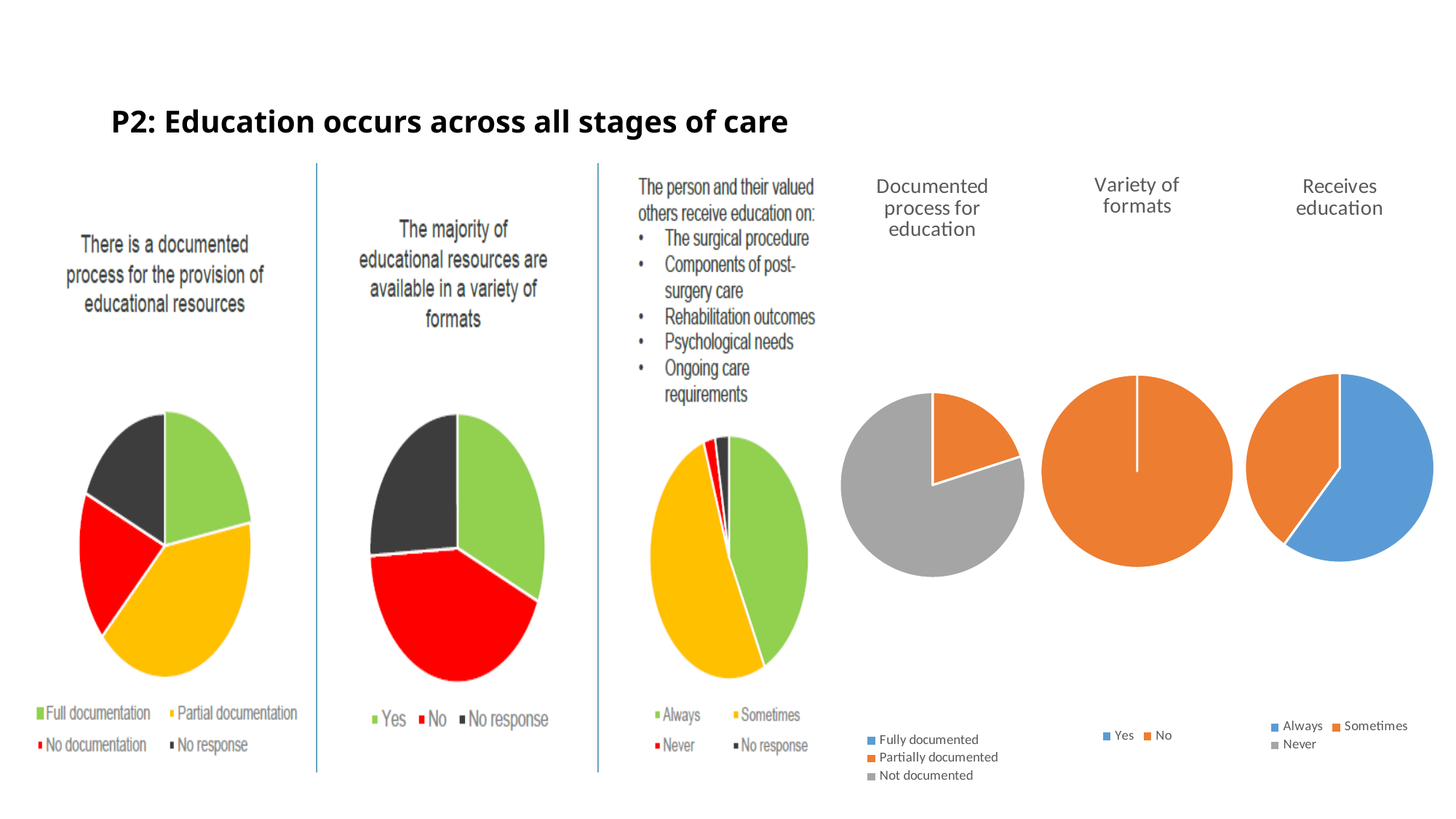
In the 'The person and their valued others receive education on' chart, which is larger, Always or Never? Always How many pie charts are shown on the slide? 6 In the 'Receives education' chart, which category has the largest slice? Always What colour represents 'Sometimes' in the 'Receives education' chart? Orange How many categories does the legend list for the 'The majority of educational resources are available in a variety of formats' chart? 3 In the 'Documented process for education' chart, which is larger, Partially documented or Not documented? Not documented What kind of chart is used for 'There is a documented process for the provision of educational resources'? Pie chart In the 'The majority of educational resources are available in a variety of formats' chart, which response has the largest slice? No In the 'Documented process for education' chart, which category has the largest slice? Not documented How many categories does the legend list for the 'There is a documented process for the provision of educational resources' chart? 4